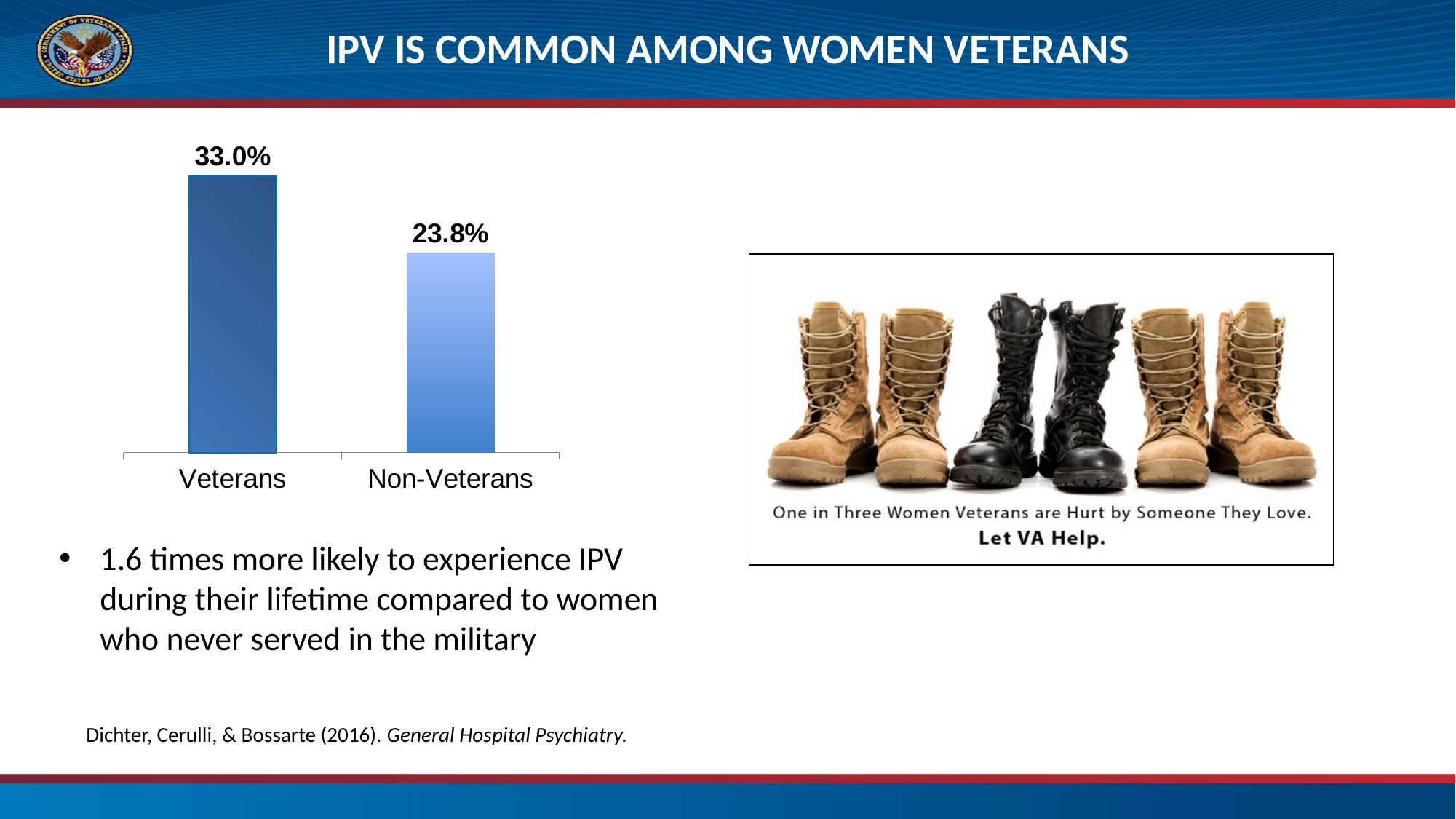
Do the values in the bar chart rise or fall from Veterans to Non-Veterans? Fall Which is larger in the bar chart, the value for Veterans or the value for Non-Veterans? Veterans What is the difference between the Veterans and Non-Veterans values in the bar chart? 9.2% What are the two category labels on the x axis of the bar chart? Veterans and Non-Veterans What kind of chart is shown on the slide? Bar chart What is the value shown for Veterans in the bar chart? 33.0% How many categories are shown in the bar chart? 2 Which category has the highest value in the bar chart? Veterans Which category has the lowest value in the bar chart? Non-Veterans What is the value shown for Non-Veterans in the bar chart? 23.8%